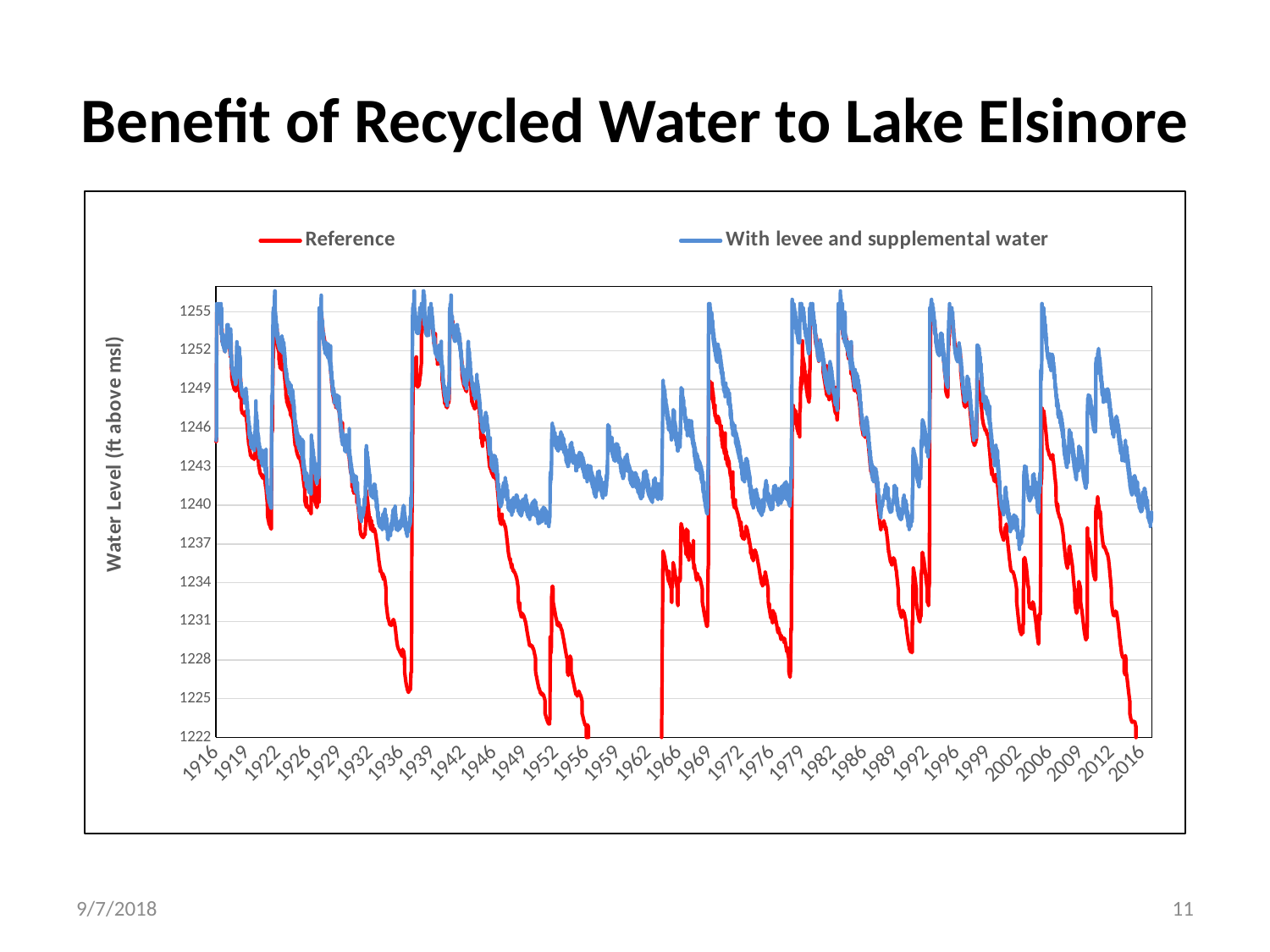
What is the y-axis title of the chart? Water Level (ft above msl) Around 1990, which series shows the higher water level, Reference or With levee and supplemental water? With levee and supplemental water Around 1956, which series shows the higher water level, Reference or With levee and supplemental water? With levee and supplemental water How many series does the legend list? 2 Around 1978, is the Reference water level greater or less than 1231? less What are the two series named in the legend? Reference; With levee and supplemental water Around 1960, is the 'With levee and supplemental water' level greater or less than 1237? greater What kind of chart is shown on the slide? line chart Does the 'With levee and supplemental water' level rise or fall between 2006 and 2016? fall Does the Reference water level rise or fall between 1942 and 1956? fall Around 1956, is the Reference water level greater or less than 1225? less